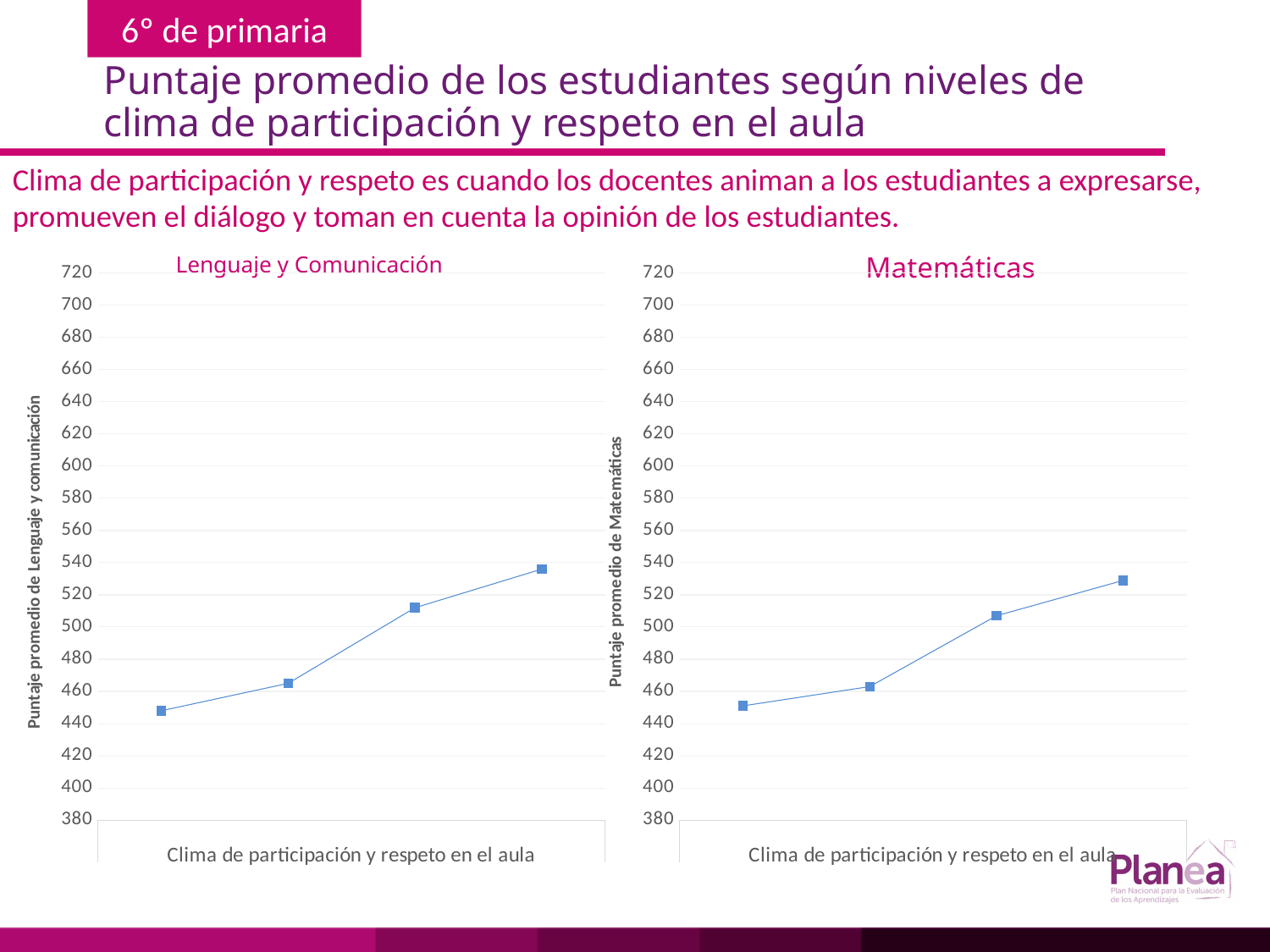
In the Matemáticas chart, which point is higher: the first (leftmost) or the last (rightmost)? the last (rightmost) In the Matemáticas chart, is the value of the last (rightmost) point greater or less than 520? greater How many data points are plotted in the Lenguaje y Comunicación chart? 4 What kind of chart is the Matemáticas chart? line chart In the Lenguaje y Comunicación chart, do the values rise or fall from left to right along the x axis? rise In the Matemáticas chart, is the value of the first (leftmost) point greater or less than 460? less How many data points are plotted in the Matemáticas chart? 4 What kind of chart is the Lenguaje y Comunicación chart? line chart What is the x-axis label of the Lenguaje y Comunicación chart? Clima de participación y respeto en el aula In the Matemáticas chart, do the values rise or fall from left to right along the x axis? rise In the Lenguaje y Comunicación chart, is the value of the last (rightmost) point greater or less than 520? greater